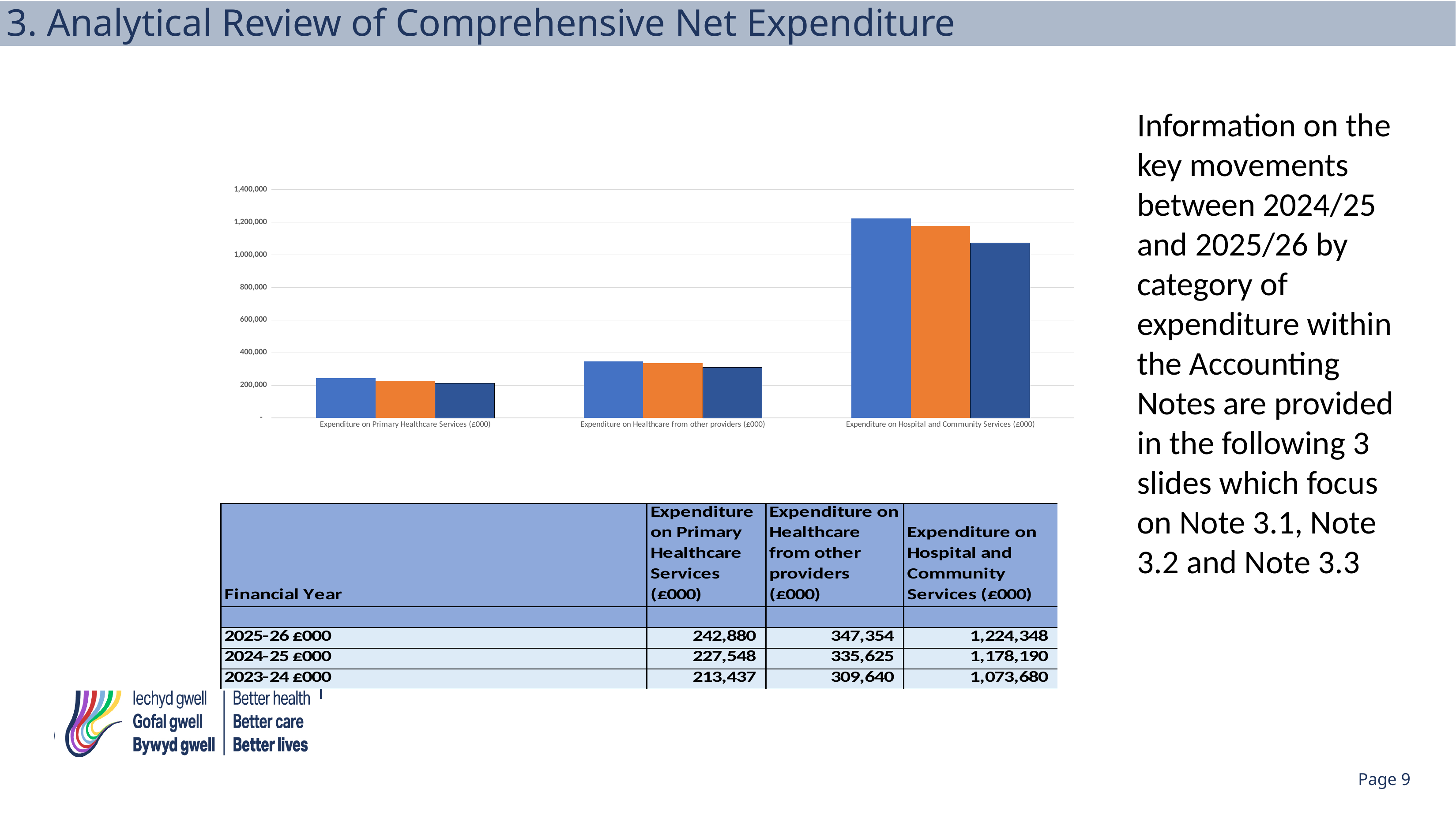
Using the table below the chart, by how much did Expenditure on Hospital and Community Services (£000) increase from 2024-25 to 2025-26? 46,158 Which expenditure category has the tallest bars in the chart? Expenditure on Hospital and Community Services (£000) Are the bars for Expenditure on Primary Healthcare Services greater or less than 400,000? less What kind of chart is shown on the slide? bar chart How many expenditure categories are shown on the x axis of the chart? 3 Are the bars for Expenditure on Healthcare from other providers greater or less than 200,000? greater According to the table below the chart, what was Expenditure on Primary Healthcare Services (£000) in 2023-24? 213,437 Which expenditure category has the shortest bars in the chart? Expenditure on Primary Healthcare Services (£000) Are the bars for Expenditure on Hospital and Community Services greater or less than 1,000,000? greater According to the table below the chart, what was Expenditure on Hospital and Community Services (£000) in 2025-26? 1,224,348 How many bars are plotted for each expenditure category in the chart? 3 Within each category of the chart, do the bars get taller or shorter from left to right? shorter